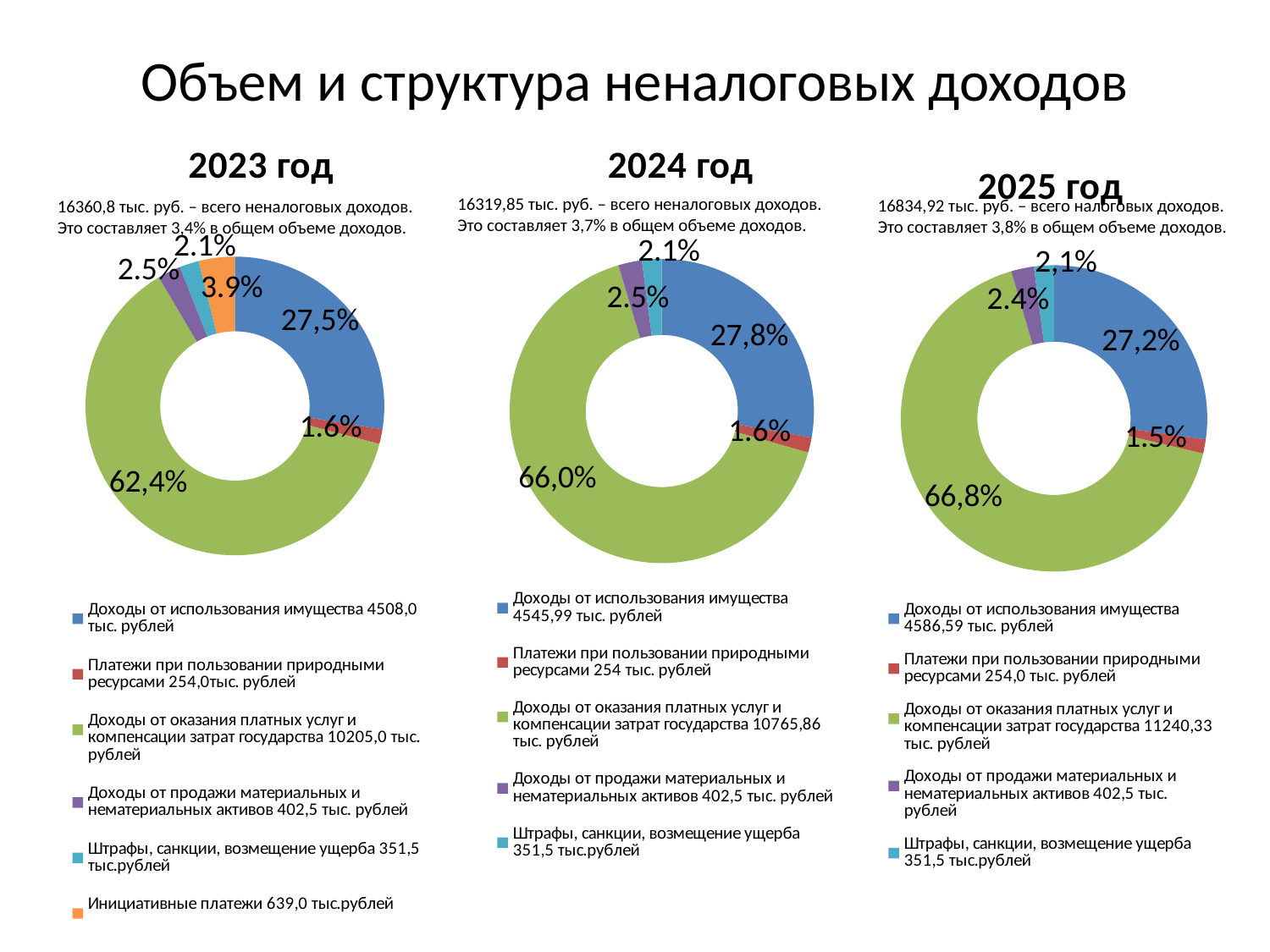
On the 2025 год chart, what share is shown for Платежи при пользовании природными ресурсами (the red slice)? 1,5% How many categories does the legend of the 2025 год chart list? 5 On the 2024 год chart, what share is shown for Доходы от использования имущества (the blue slice)? 27,8% On the 2023 год chart, what share is shown for Доходы от оказания платных услуг и компенсации затрат государства (the green slice)? 62,4% On the 2025 год chart, which category has the largest share? Доходы от оказания платных услуг и компенсации затрат государства On the 2023 год chart, what share is shown for Инициативные платежи (the orange slice)? 3,9% What kind of chart is used for each year on this slide? Doughnut (pie) chart What is the title of the slide? Объем и структура неналоговых доходов How many categories does the legend of the 2023 год chart list? 6 Which is larger: the green slice on the 2024 год chart or the green slice on the 2025 год chart? 2025 год (66,8%) On the 2023 год chart, what is the difference between the shares of the green slice (62,4%) and the blue slice (27,5%)? 34,9% On the 2024 год chart, which category has the smallest share? Платежи при пользовании природными ресурсами